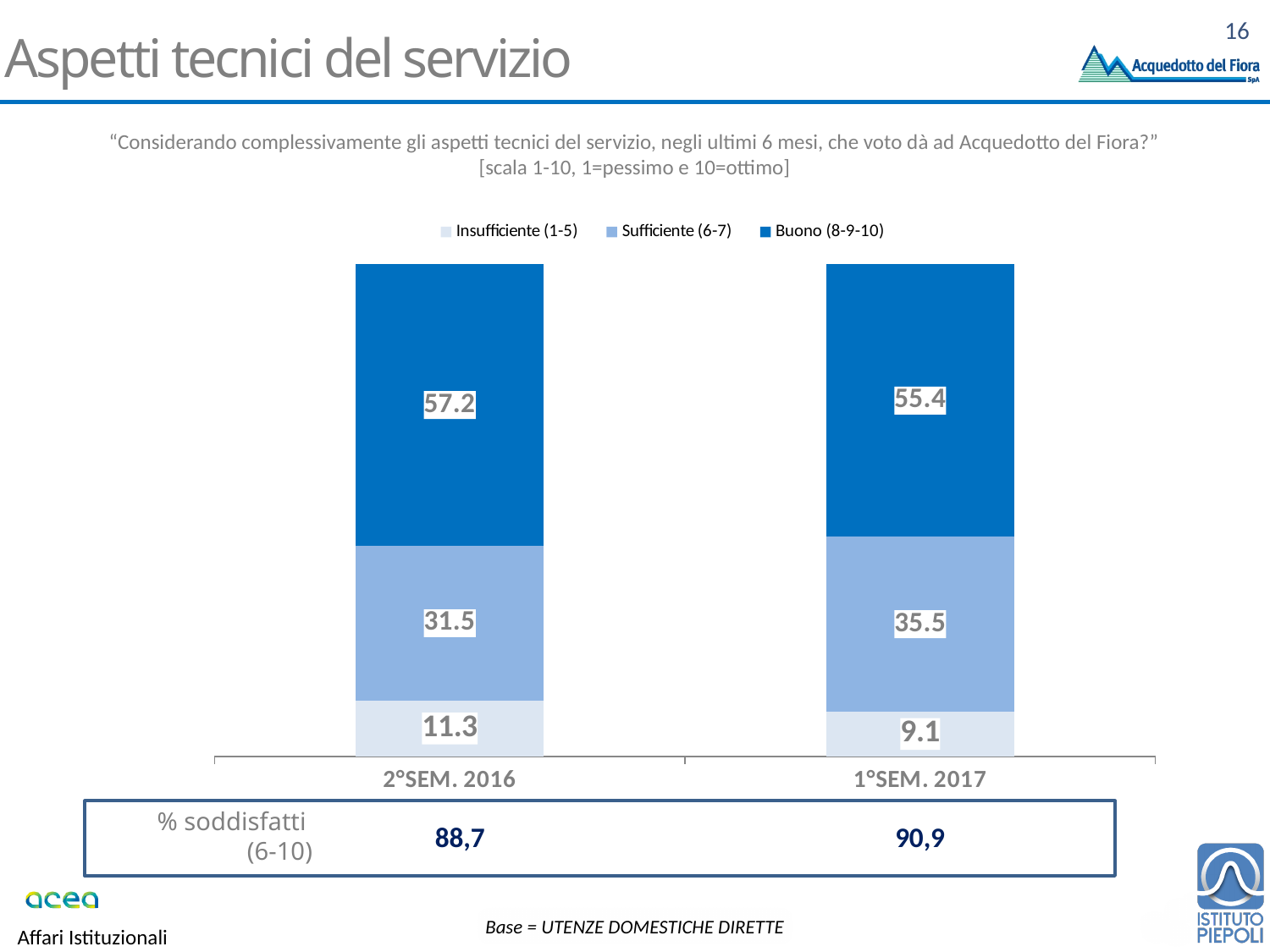
Which period has the higher Buono (8-9-10) value? 2°SEM. 2016 What is the value of the Buono (8-9-10) segment for 2°SEM. 2016? 57.2 What is the difference between the Buono (8-9-10) values for 2°SEM. 2016 and 1°SEM. 2017? 1.8 What is the value of the Insufficiente (1-5) segment for 1°SEM. 2017? 9.1 What is the value of the Insufficiente (1-5) segment for 2°SEM. 2016? 11.3 What kind of chart is shown on the slide? Stacked bar chart What is the difference between the Sufficiente (6-7) values for 1°SEM. 2017 and 2°SEM. 2016? 4.0 Which period has the lower Insufficiente (1-5) value? 1°SEM. 2017 How many periods (categories) are shown on the x axis? 2 What is the total of the stacked bar for 1°SEM. 2017? 100.0 What is the value of the Sufficiente (6-7) segment for 1°SEM. 2017? 35.5 How many series does the legend list? 3